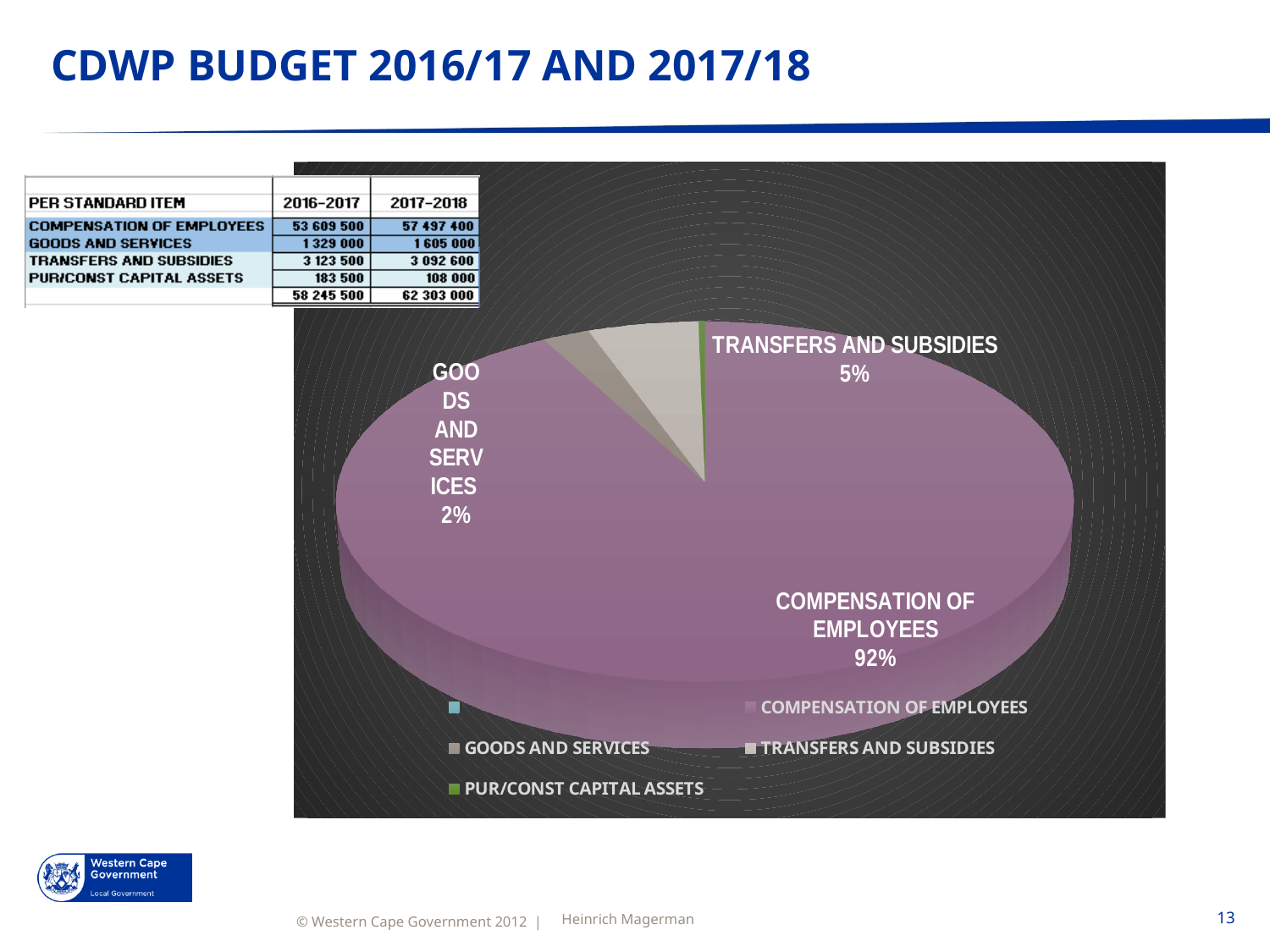
What percentage of the pie chart is Compensation of Employees? 92% How many named categories are listed in the pie chart's legend? 4 Which category has the smallest slice of the pie chart? Pur/Const Capital Assets Is the share for Compensation of Employees greater or less than 50%? greater Which legend entry in the pie chart is shown with a green marker? Pur/Const Capital Assets What percentage of the pie chart is Goods and Services? 2% What percentage of the pie chart is Transfers and Subsidies? 5% By how many percentage points does the Compensation of Employees slice exceed the Transfers and Subsidies slice? 87 percentage points Which category has the largest slice of the pie chart? Compensation of Employees Which slice is larger in the pie chart, Transfers and Subsidies or Goods and Services? Transfers and Subsidies What kind of chart is shown on the slide? Pie chart By how many percentage points does the Transfers and Subsidies slice exceed the Goods and Services slice? 3 percentage points